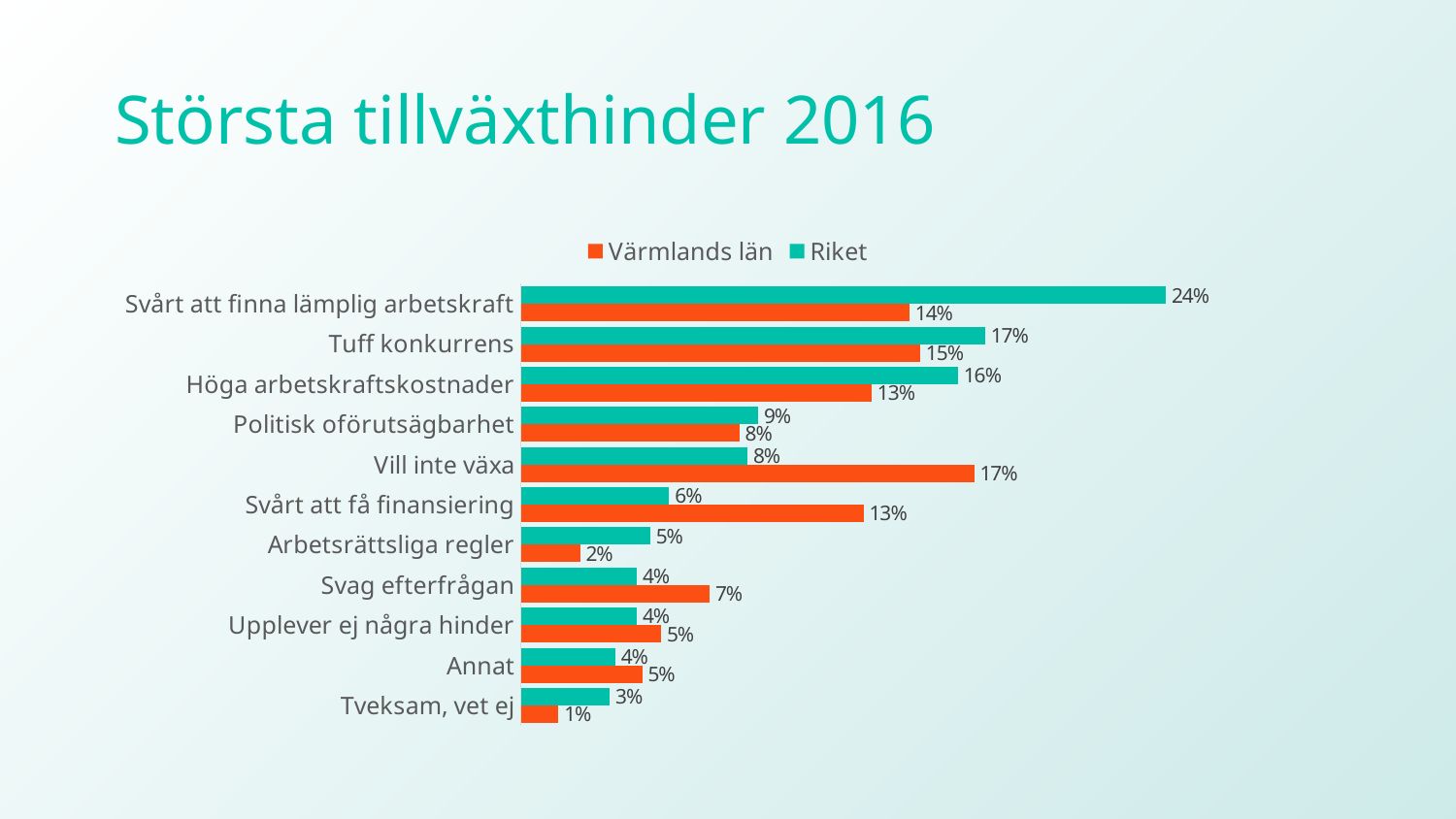
Which category has the lowest Värmlands län value? Tveksam, vet ej What is the Riket value for Tuff konkurrens? 17% How many categories are shown in the chart? 11 What is the Värmlands län value for Vill inte växa? 17% Which category has the highest Värmlands län value? Vill inte växa For Svårt att få finansiering, which is larger: the Värmlands län value or the Riket value? Värmlands län Which category has the highest Riket value? Svårt att finna lämplig arbetskraft How many series does the legend list? 2 What is the Värmlands län value for Svårt att få finansiering? 13% What kind of chart is shown on the slide? Bar chart What is the difference between the Riket and Värmlands län values for Svårt att finna lämplig arbetskraft? 10% What is the Riket value for Svårt att finna lämplig arbetskraft? 24%